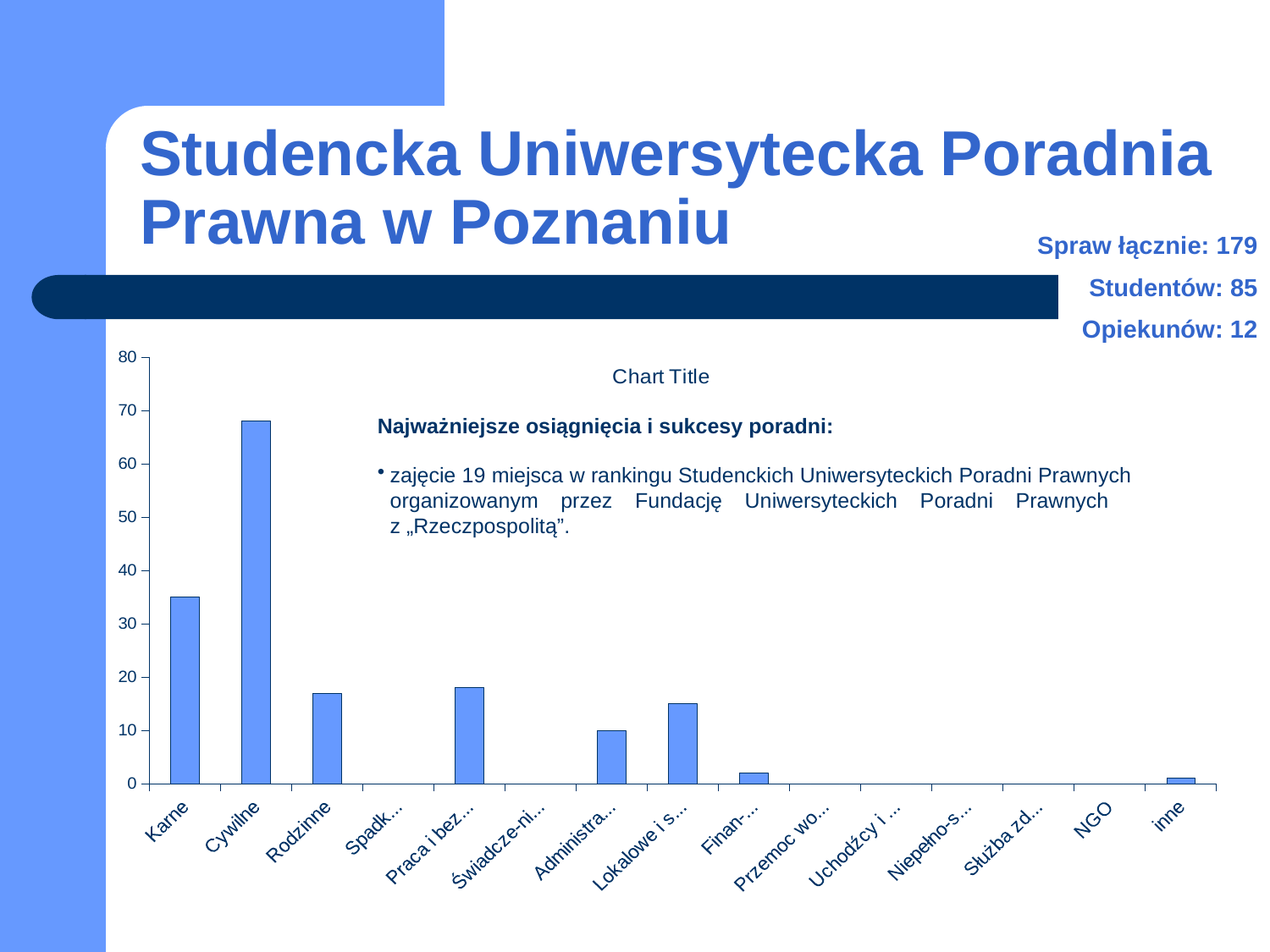
What kind of chart is shown on the slide? bar chart Is the value for Cywilne greater or less than 70? less Which category has the highest bar in the chart? Cywilne Is the value for Finan-... greater or less than 10? less Is the value for Rodzinne greater or less than 20? less Which is larger, the value for Administra... or the value for Lokalowe i s...? Lokalowe i s... What is the title shown on the chart? Chart Title How many categories are shown on the x axis of the chart? 15 Which is larger, the value for Karne or the value for Cywilne? Cywilne